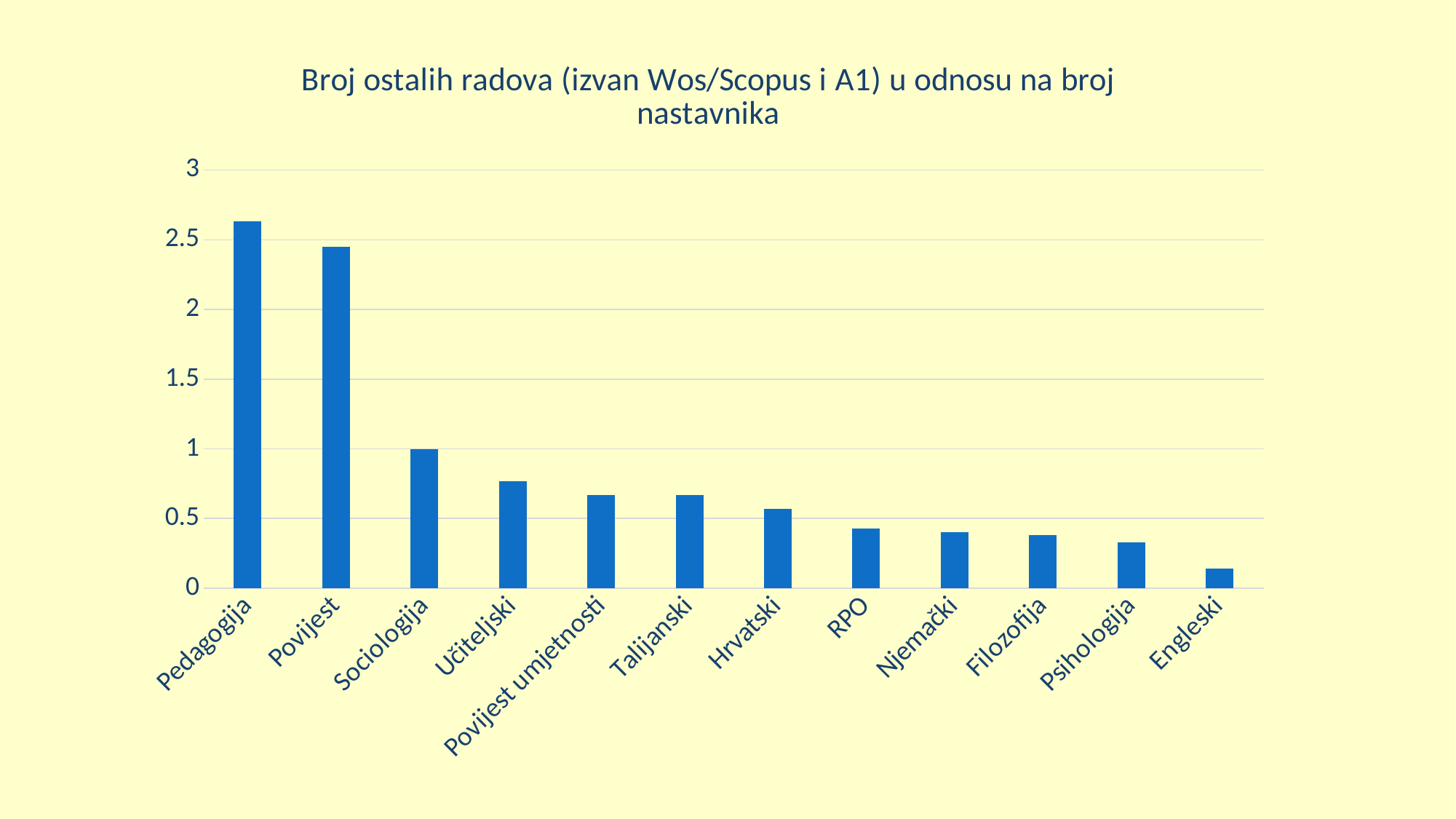
Which category has the lowest value in the chart? Engleski What is the value for Sociologija? 1 Is the value for Pedagogija greater or less than 2.5? greater Is the value for Engleski greater or less than 0.5? less What type of chart is shown on the slide? bar chart Is the value for Učiteljski greater or less than 0.5? greater How many categories are shown on the x axis of the chart? 12 Which has a larger value, Pedagogija or Povijest? Pedagogija Do the values rise or fall from left to right along the x axis? fall What is the title of the chart? Broj ostalih radova (izvan Wos/Scopus i A1) u odnosu na broj nastavnika Which category has the highest value in the chart? Pedagogija